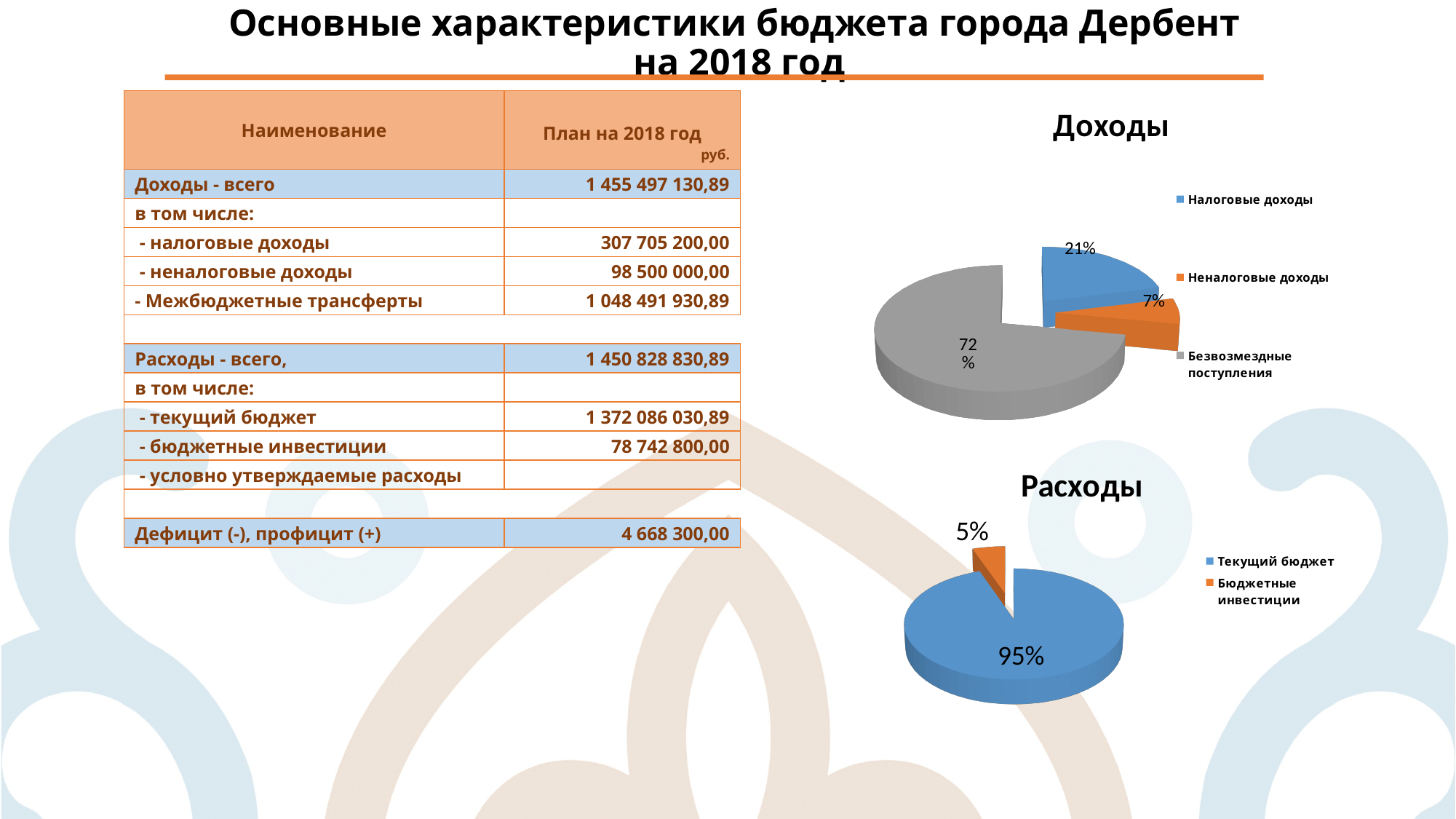
In the "Доходы" chart, which category has the largest slice? Безвозмездные поступления In the "Доходы" chart, what share is labelled for Безвозмездные поступления? 72% In the "Расходы" chart, which is larger: Текущий бюджет or Бюджетные инвестиции? Текущий бюджет In the "Расходы" chart, what share is labelled for Бюджетные инвестиции? 5% In the "Доходы" chart, what share is labelled for Неналоговые доходы? 7% In the "Доходы" chart, which category has the smallest slice? Неналоговые доходы In the "Доходы" chart, how many categories does the legend list? 3 What type of chart is the "Расходы" chart? Pie chart In the "Доходы" chart, what is the difference in percentage points between Безвозмездные поступления and Налоговые доходы? 51 In the "Расходы" chart, what colour is the Бюджетные инвестиции slice? Orange